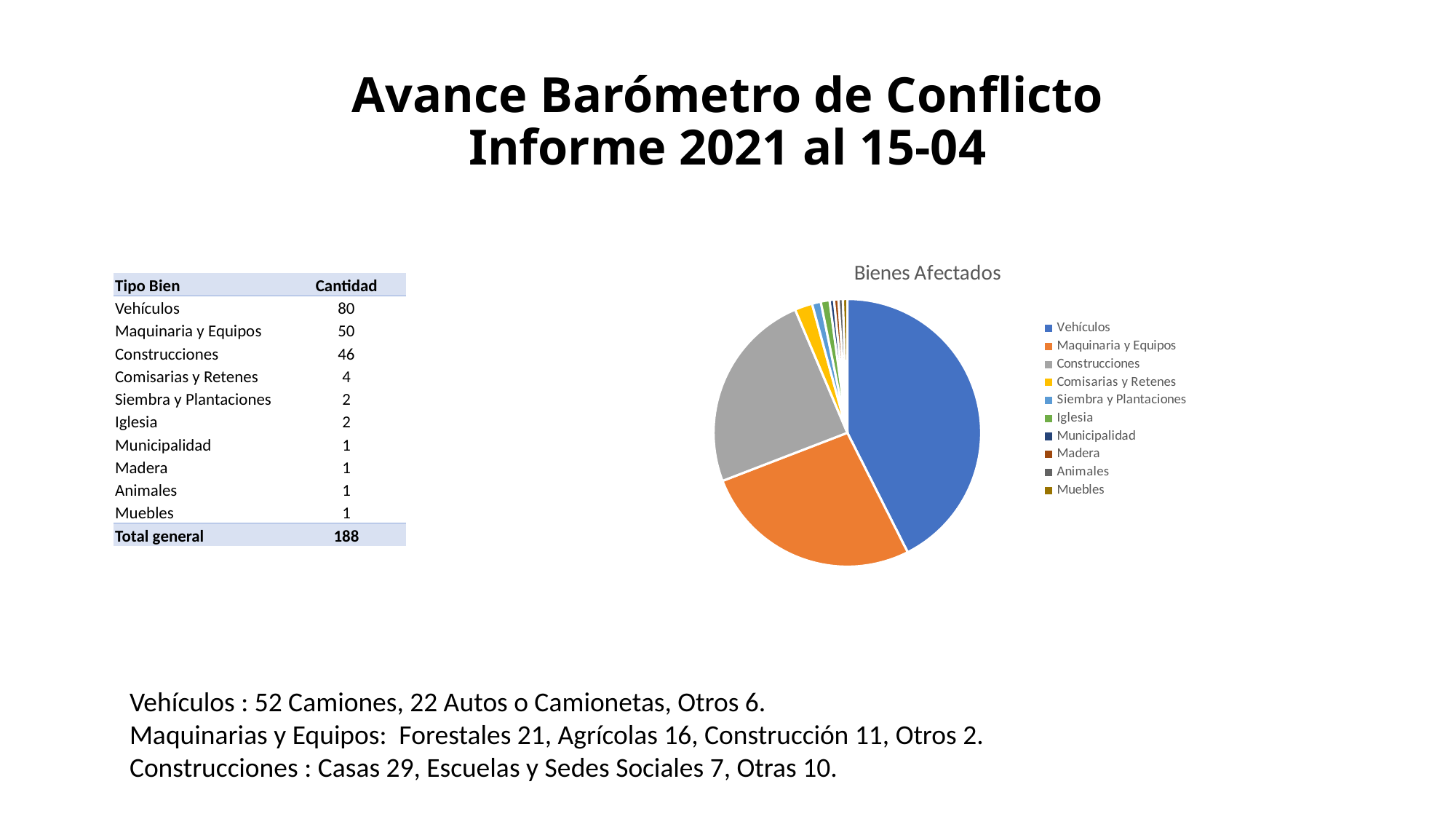
What is the difference between the Cantidad for Vehículos and for Maquinaria y Equipos shown in the table? 30 What is the Total general shown in the table on the slide? 188 How many categories does the legend of the "Bienes Afectados" pie chart list? 10 Which category has the second-largest slice in the "Bienes Afectados" pie chart? Maquinaria y Equipos According to the table on the slide, what is the Cantidad for Comisarias y Retenes? 4 Which colour represents Maquinaria y Equipos in the "Bienes Afectados" pie chart? orange Which category has the largest slice in the "Bienes Afectados" pie chart? Vehículos Which is larger in the table, the Cantidad for Maquinaria y Equipos or for Construcciones? Maquinaria y Equipos What is the title of the pie chart on the slide? Bienes Afectados What kind of chart is the "Bienes Afectados" chart? pie chart According to the table on the slide, what is the Cantidad for Construcciones? 46 According to the table on the slide, what is the Cantidad for Vehículos? 80